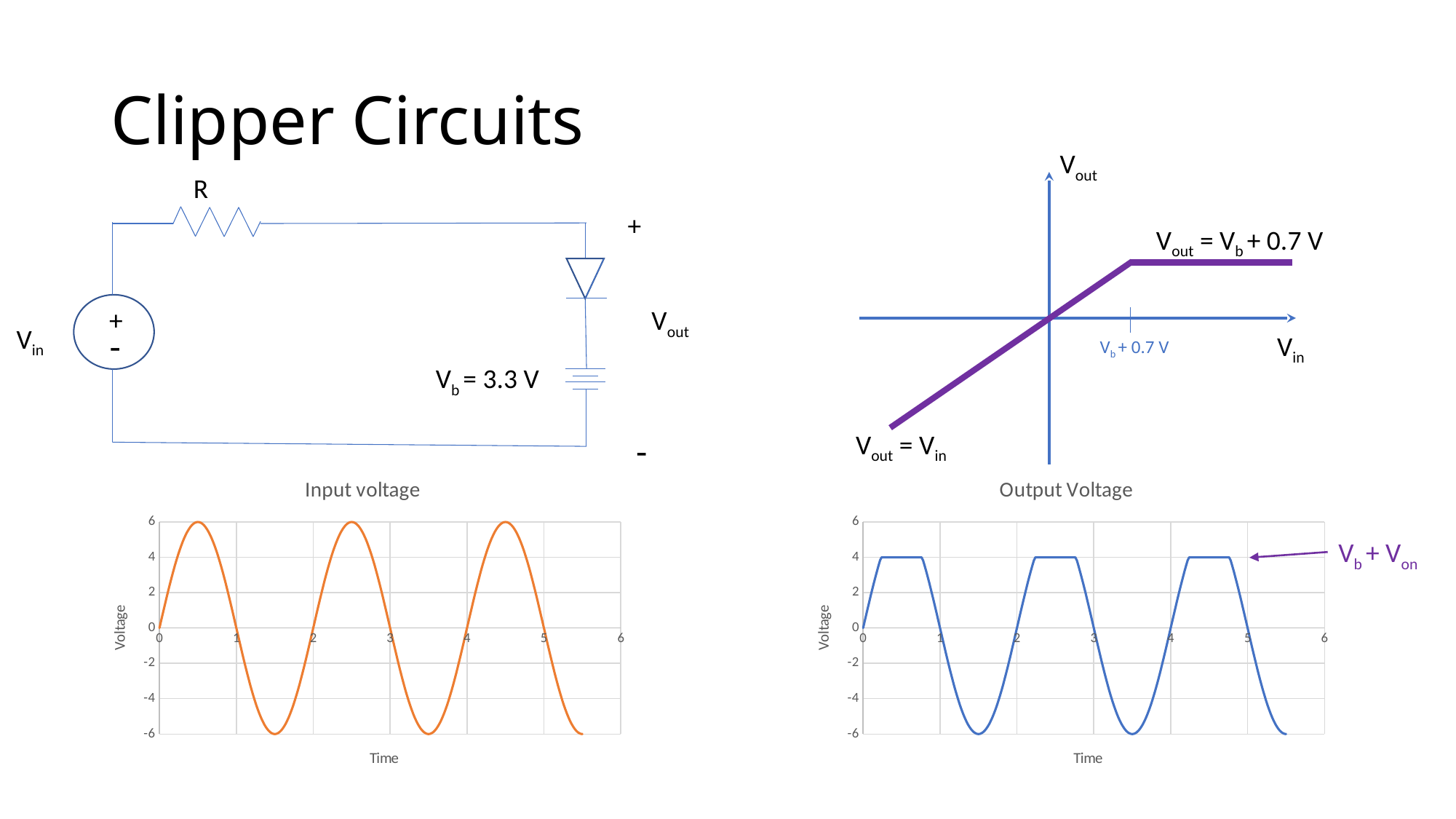
What kind of chart is the "Input voltage" chart? line chart Which chart has the higher peak value, "Input voltage" or "Output Voltage"? Input voltage What is the x-axis label of the "Output Voltage" chart? Time What is the lowest value reached by the line in the "Input voltage" chart? -6 What colour is the line in the "Input voltage" chart? orange What is the difference between the peak value in the "Input voltage" chart and the peak value in the "Output Voltage" chart? 2 What is the lowest value reached by the line in the "Output Voltage" chart? -6 In the "Input voltage" chart, does the line rise or fall between time 0 and time 0.5? rise In the "Output Voltage" chart, is the value at time 0.5 greater or less than 6? less What is the peak (maximum) value reached by the line in the "Input voltage" chart? 6 In the "Input voltage" chart, is the value at time 0.5 greater or less than 4? greater What is the maximum value reached by the line in the "Output Voltage" chart? 4